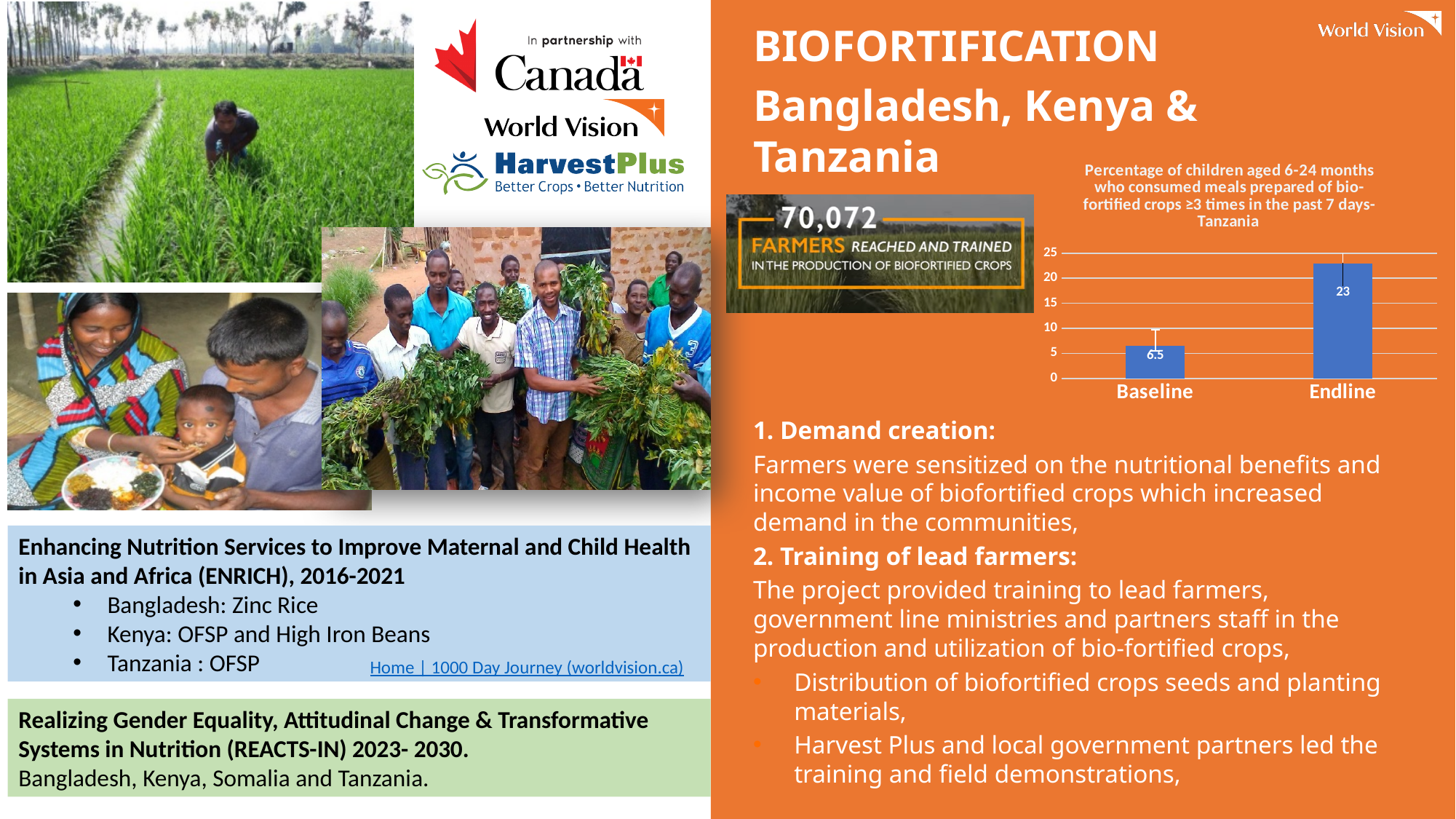
Do the values rise or fall from Baseline to Endline? rise What is the value for Baseline in the chart? 6.5 What is the difference between the Endline and Baseline values? 16.5 Is the value for Endline greater or less than 20? greater How many categories are shown on the x axis of the chart? 2 What is the value for Endline in the chart? 23 What kind of chart is shown on the slide? bar chart Which category has the highest value in the chart? Endline Is the value for Baseline greater or less than 10? less Which category has the lowest value in the chart? Baseline Which is larger, the Baseline value or the Endline value? Endline Which country does the chart title say the data is for? Tanzania